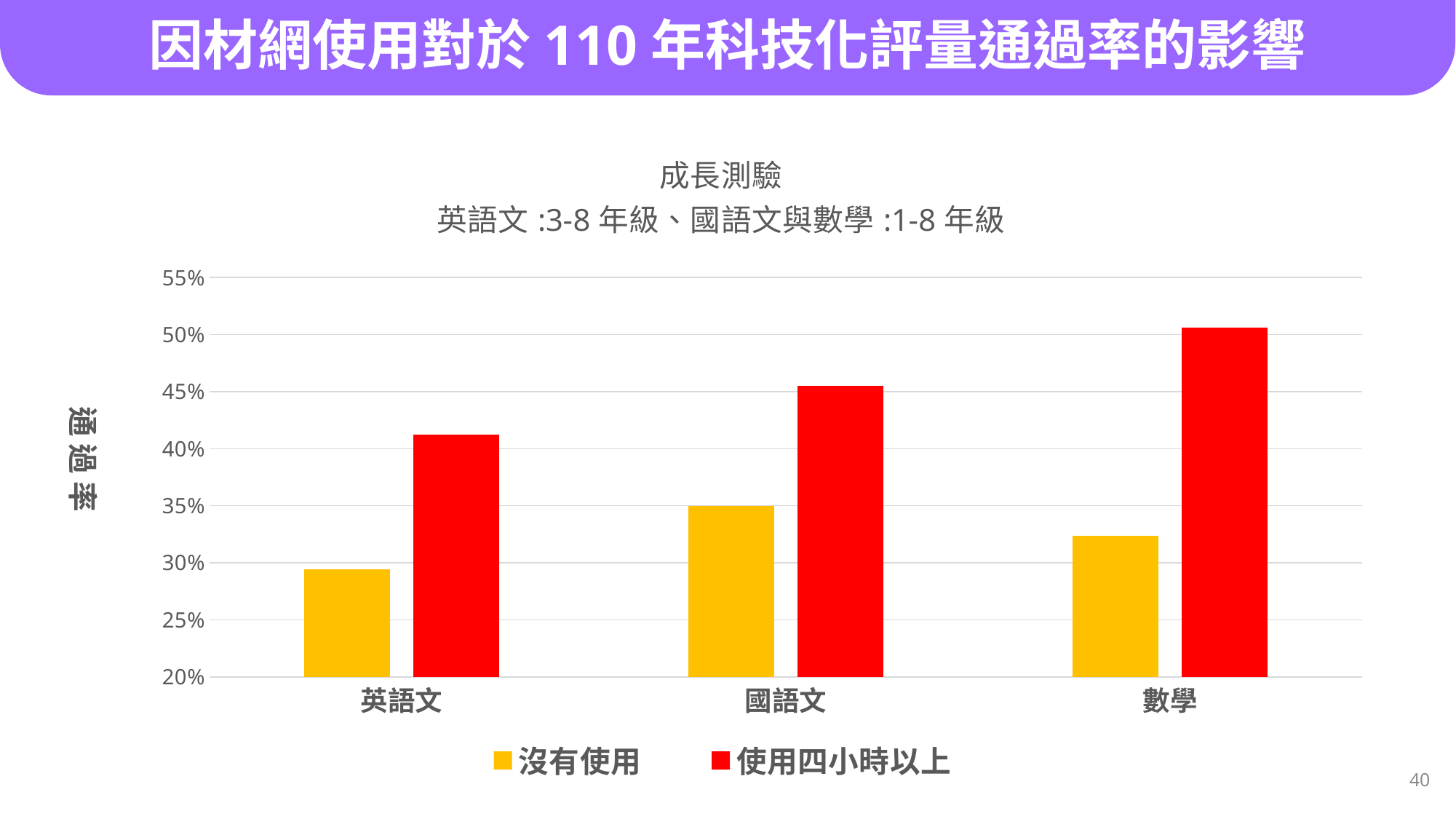
Which subject has the highest pass rate for 使用四小時以上? 數學 Which colour represents the 沒有使用 series in the legend? Yellow Is the 沒有使用 pass rate for 數學 greater or less than 30%? greater Is the 使用四小時以上 pass rate for 國語文 greater or less than 50%? less Which subject has the lowest pass rate for 沒有使用? 英語文 How many subject categories are shown on the x axis? 3 For 沒有使用, which subject has the larger pass rate: 國語文 or 數學? 國語文 Is the 使用四小時以上 pass rate for 英語文 greater or less than 40%? greater What kind of chart is shown on the slide? Bar chart How many series does the legend list? 2 Do the 使用四小時以上 pass rates rise or fall from 英語文 to 數學 along the x axis? rise